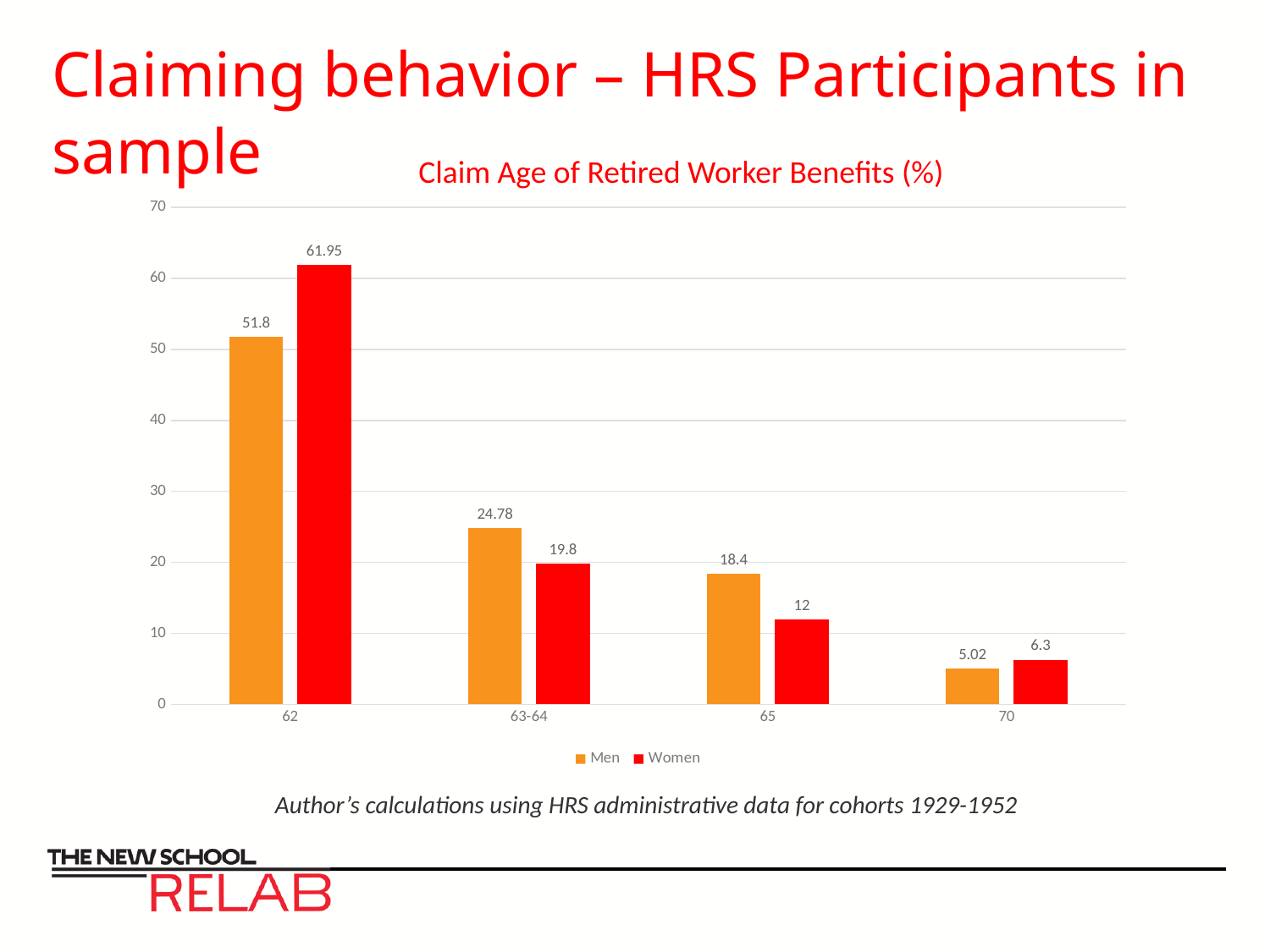
What is the value for Women at claim age 63-64? 19.8 At claim age 63-64, which series has the larger value, Men or Women? Men How many claim age categories are shown on the x axis? 4 What is the title of the chart? Claim Age of Retired Worker Benefits (%) What is the value for Women at claim age 70? 6.3 What is the difference between the Men and Women values at claim age 65? 6.4 Which claim age has the lowest value for Men? 70 Which claim age has the highest value for Women? 62 What kind of chart is shown on the slide? Bar chart What is the value for Men at claim age 62? 51.8 How many series does the legend list? 2 What is the difference between the Women and Men values at claim age 62? 10.15